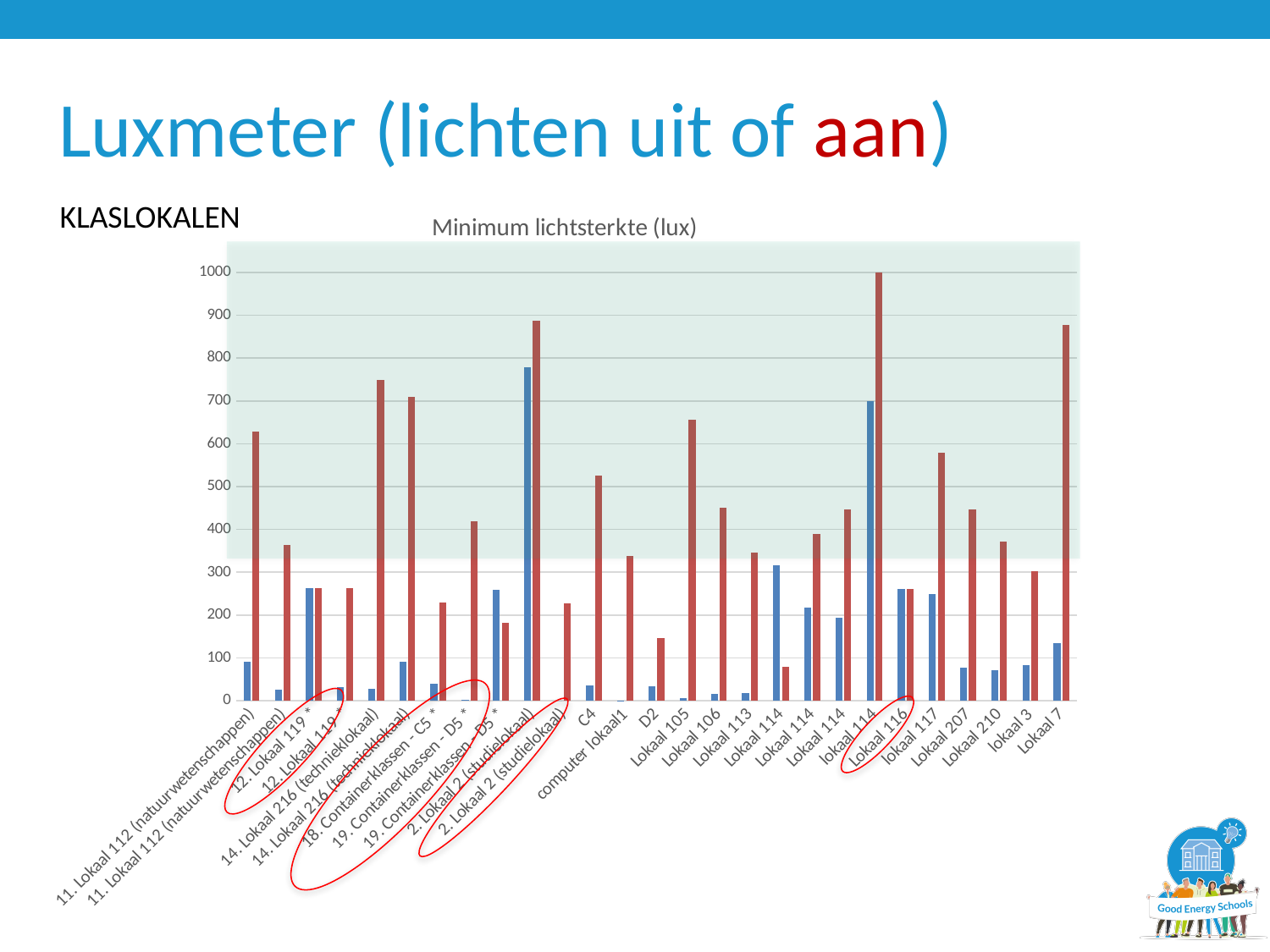
What kind of chart is shown on the slide? bar chart Is the red bar for Lokaal 105 greater or less than 600? greater Is the red bar for Lokaal 210 greater or less than 300? greater Is the red bar for D2 greater or less than 200? less Which category has the tallest blue bar in the chart? 2. Lokaal 2 (studielokaal) For Lokaal 7, which bar is taller, the blue one or the red one? the red one What is the highest value shown on the vertical axis of the chart? 1000 How many categories are shown on the x axis of the chart? 27 What is the title of the chart? Minimum lichtsterkte (lux) Which category has the tallest red bar in the chart? lokaal 114